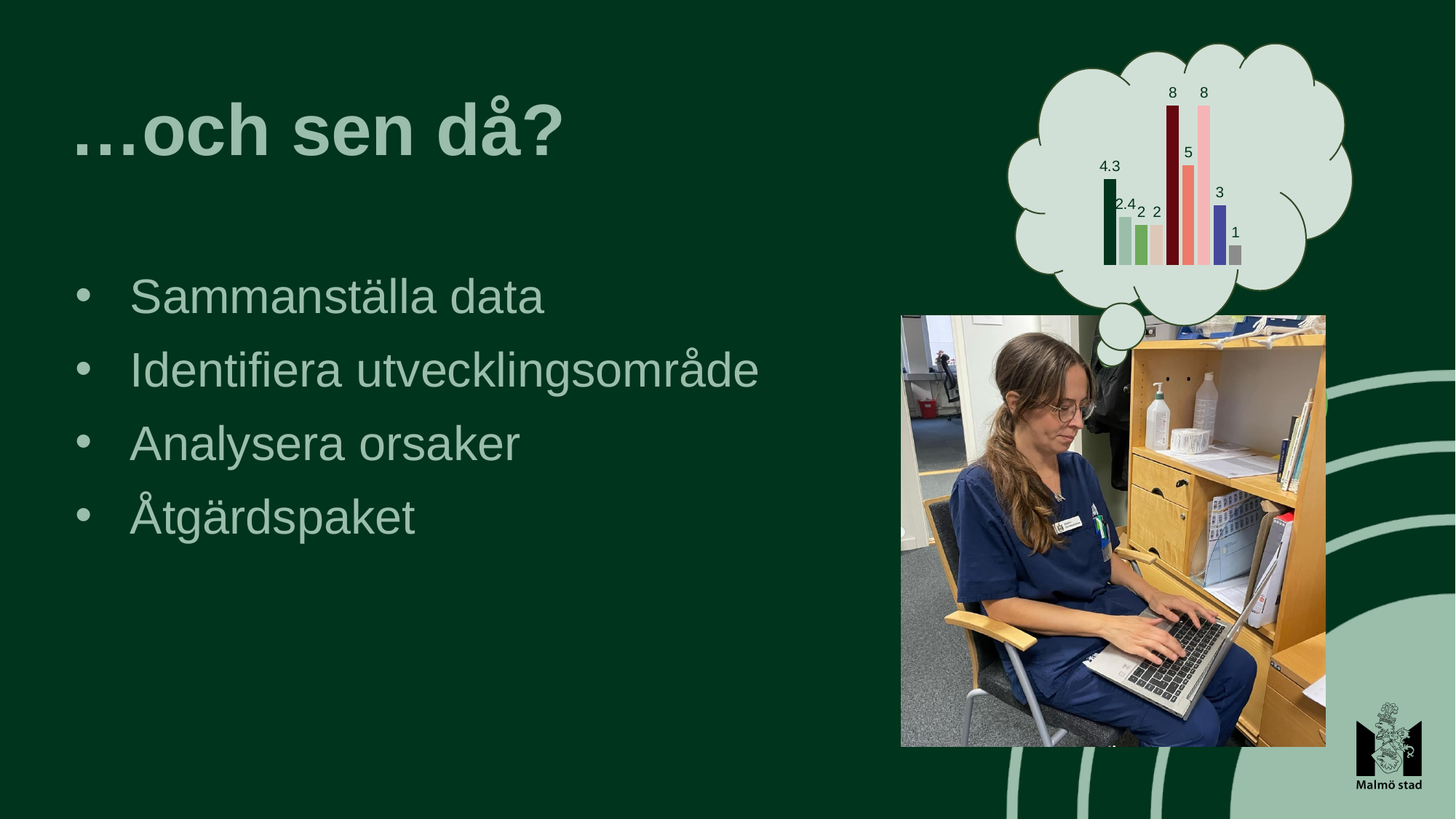
What is the value labelled on the blue bar of the chart in the thought bubble? 3 What is the value labelled on the first (dark green) bar of the chart in the thought bubble? 4.3 In the chart in the thought bubble, which is larger: the salmon bar or the dark green bar? the salmon bar What is the highest value labelled on the chart in the thought bubble? 8 What is the value labelled on the last (grey) bar of the chart in the thought bubble? 1 In the chart in the thought bubble, what is the difference between the dark red bar (8) and the salmon bar (5)? 3 How many bars does the chart in the thought bubble have? 9 In the chart in the thought bubble, what is the difference between the dark green bar (4.3) and the light green bar (2.4)? 1.9 What kind of chart is shown inside the thought bubble on the slide? bar chart In the chart in the thought bubble, which is larger: the blue bar or the grey bar? the blue bar What is the lowest value labelled on the chart in the thought bubble? 1 What is the value labelled on the second (light green) bar of the chart in the thought bubble? 2.4